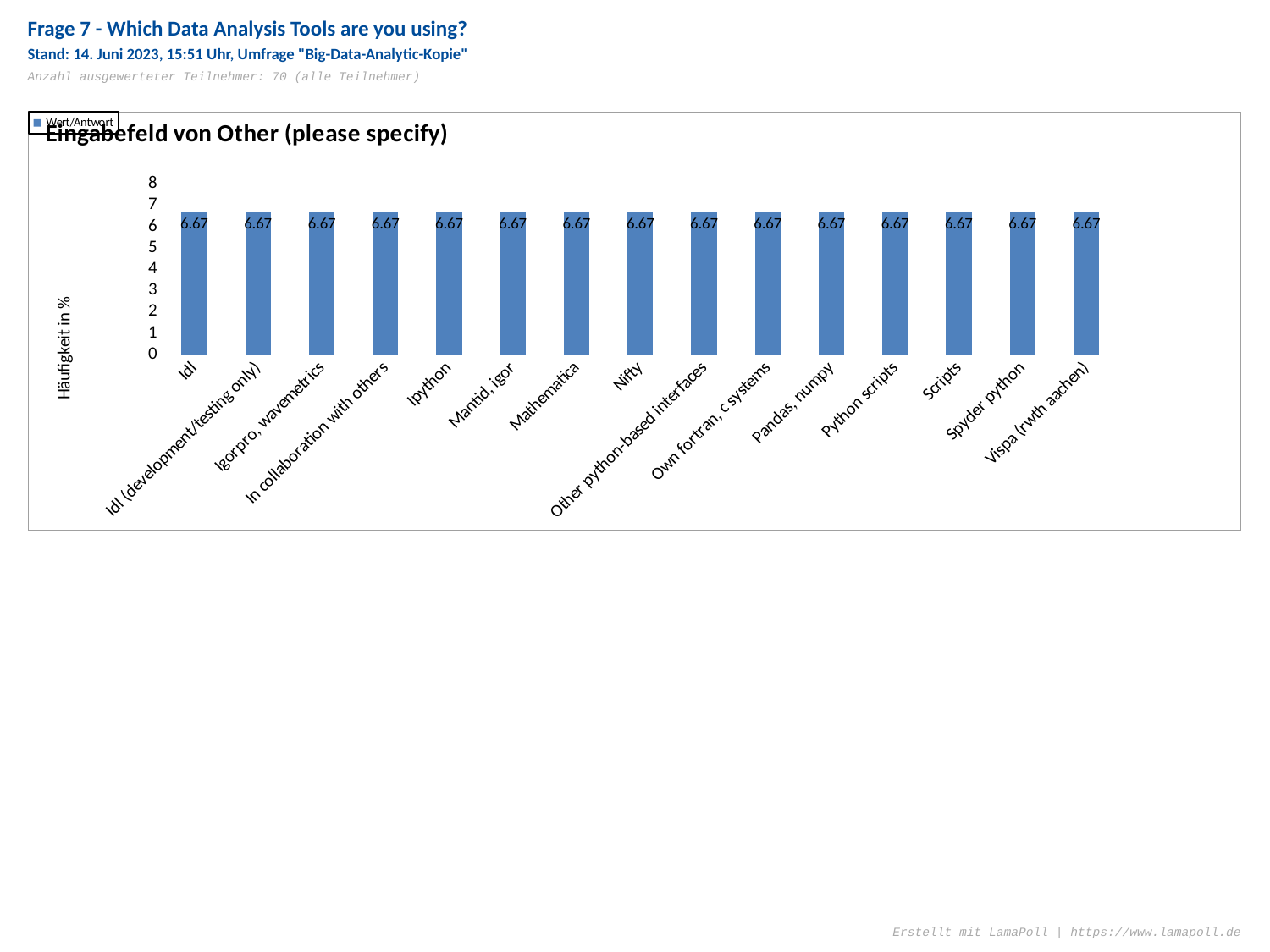
What is the legend entry shown for the series? Wert/Antwort Is the value for Spyder python greater or less than 5? greater What is the value for Mathematica? 6.67 What type of chart is shown on the slide? bar chart What is the difference between the values for Nifty and Scripts? 0 How many categories are plotted in the chart? 15 What is the label of the y axis? Häufigkeit in % What is the value for Vispa (rwth aachen)? 6.67 What is the value for Pandas, numpy? 6.67 Do the values rise, fall or stay flat across the categories along the x axis? stay flat What is the value for Ipython? 6.67 How many series does the legend list? 1